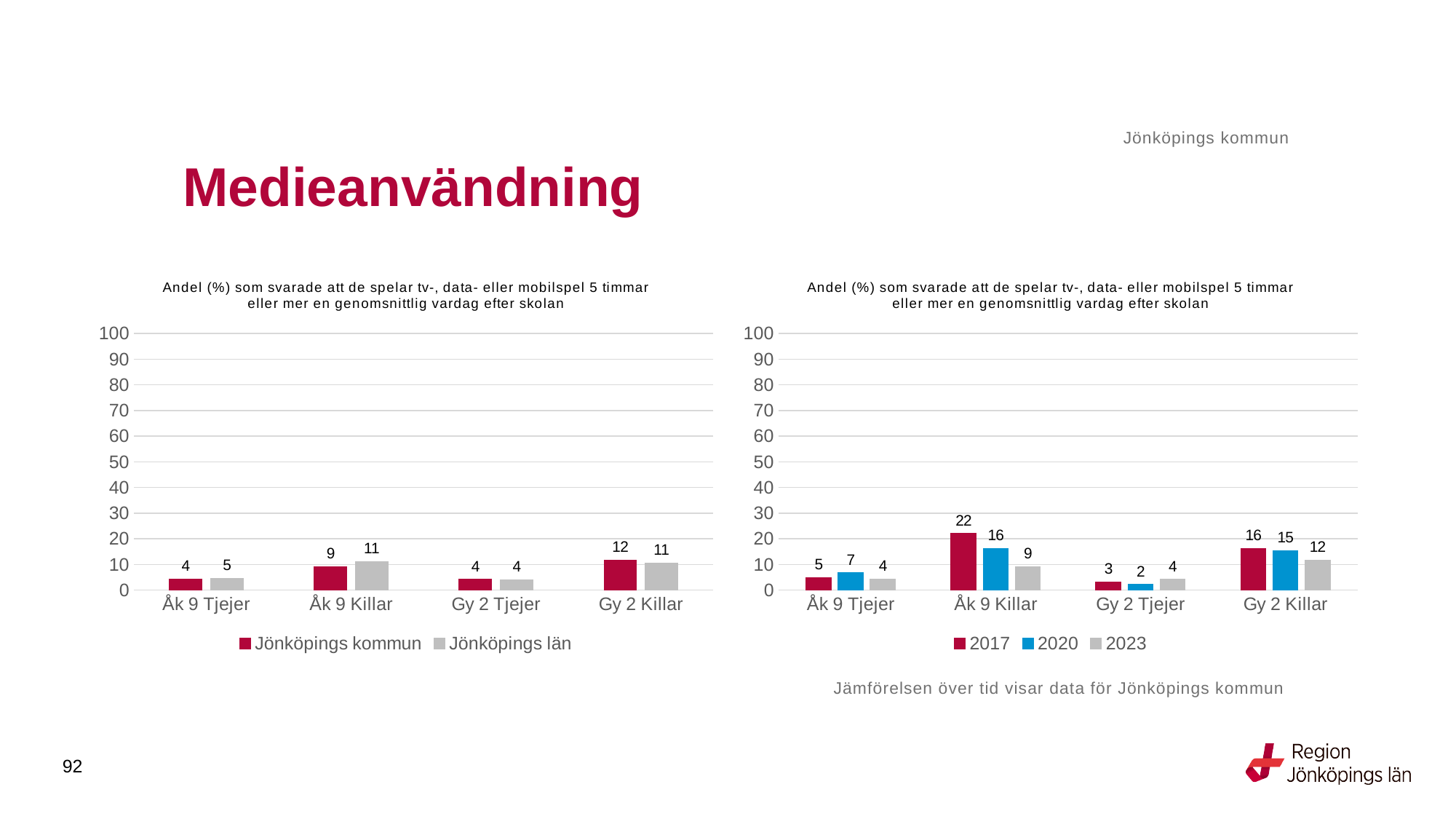
In the right chart, what is the difference between the 2017 and 2023 values for Åk 9 Killar? 13 In the right chart, is the 2017 value for Gy 2 Killar larger or the 2023 value for Gy 2 Killar? 2017 In the left chart, what is the difference between Jönköpings län and Jönköpings kommun for Åk 9 Killar? 2 In the right chart, how does the value for Åk 9 Killar change from 2017 to 2023? It falls In the right chart, what is the value for 2020 for Gy 2 Tjejer? 2 In the right chart, which category has the lowest value for 2023? Åk 9 Tjejer and Gy 2 Tjejer (tied at 4) In the left chart, what is the value for Jönköpings kommun for Åk 9 Killar? 9 In the left chart, what is the value for Jönköpings län for Gy 2 Killar? 11 In the left chart, which category has the highest value for Jönköpings kommun? Gy 2 Killar In the left chart, how many series does the legend list? 2 In the right chart, what is the value for 2017 for Åk 9 Killar? 22 What kind of chart is the right chart? Bar chart